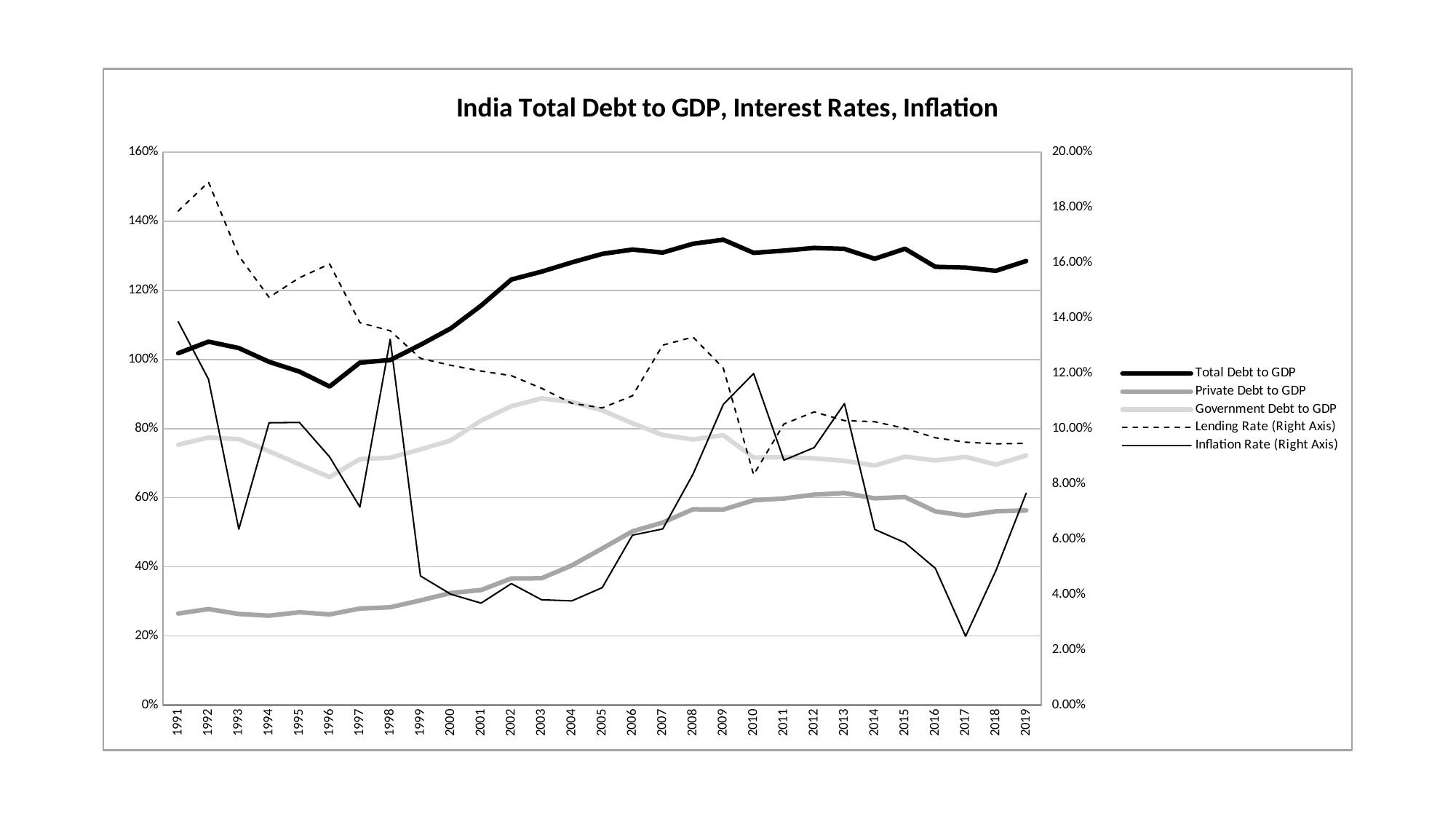
In which year is the Lending Rate highest? 1992 What is the title of the chart? India Total Debt to GDP, Interest Rates, Inflation Is the Inflation Rate in 2017 greater or less than 4.00%? less How many years are plotted along the x axis? 29 Is the Lending Rate in 1992 greater or less than 18.00%? greater Is the value for Total Debt to GDP in 1996 greater or less than 100%? less Which is larger in 2019, Private Debt to GDP or Government Debt to GDP? Government Debt to GDP What kind of chart is shown on the slide? Line chart In which year is the Government Debt to GDP lowest? 1996 Which two series are plotted against the right axis according to the legend? Lending Rate and Inflation Rate How many series does the legend list? 5